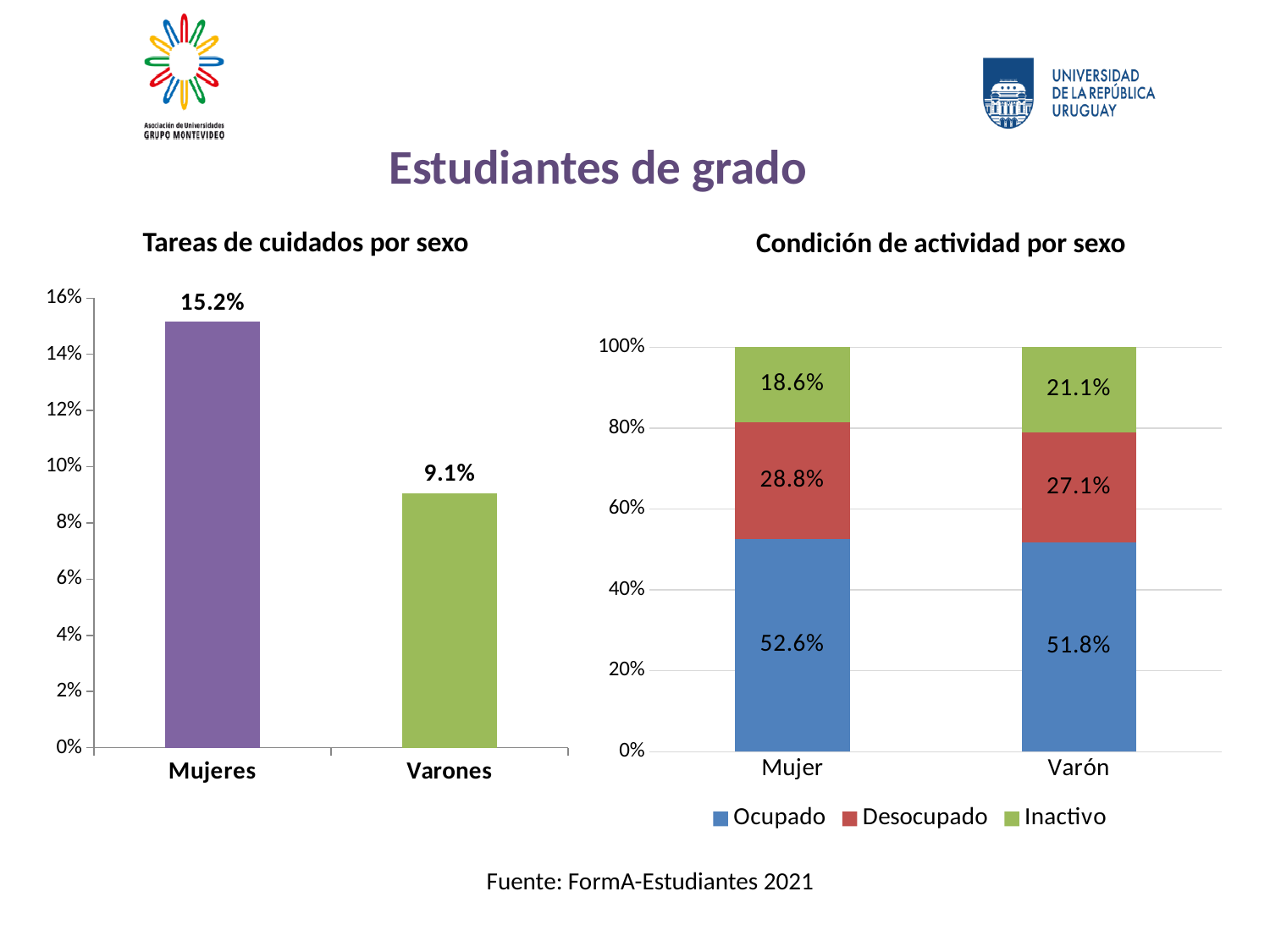
In the 'Tareas de cuidados por sexo' chart, what is the value for Varones? 9.1% In the 'Condición de actividad por sexo' chart, what is the Ocupado value for Mujer? 52.6% What kind of chart is the 'Condición de actividad por sexo' chart? Stacked bar chart In the 'Condición de actividad por sexo' chart, what is the Desocupado value for Mujer? 28.8% In the 'Condición de actividad por sexo' chart, what is the difference between the Desocupado values for Mujer and Varón? 1.7% In the 'Condición de actividad por sexo' chart, what is the Inactivo value for Varón? 21.1% In the 'Tareas de cuidados por sexo' chart, how many categories are shown? 2 In the 'Tareas de cuidados por sexo' chart, which category has the higher value? Mujeres In the 'Condición de actividad por sexo' chart, how many series does the legend list? 3 In the 'Condición de actividad por sexo' chart, which category has the larger Inactivo value, Mujer or Varón? Varón In the 'Tareas de cuidados por sexo' chart, what is the value for Mujeres? 15.2% In the 'Tareas de cuidados por sexo' chart, what is the difference between the values for Mujeres and Varones? 6.1%